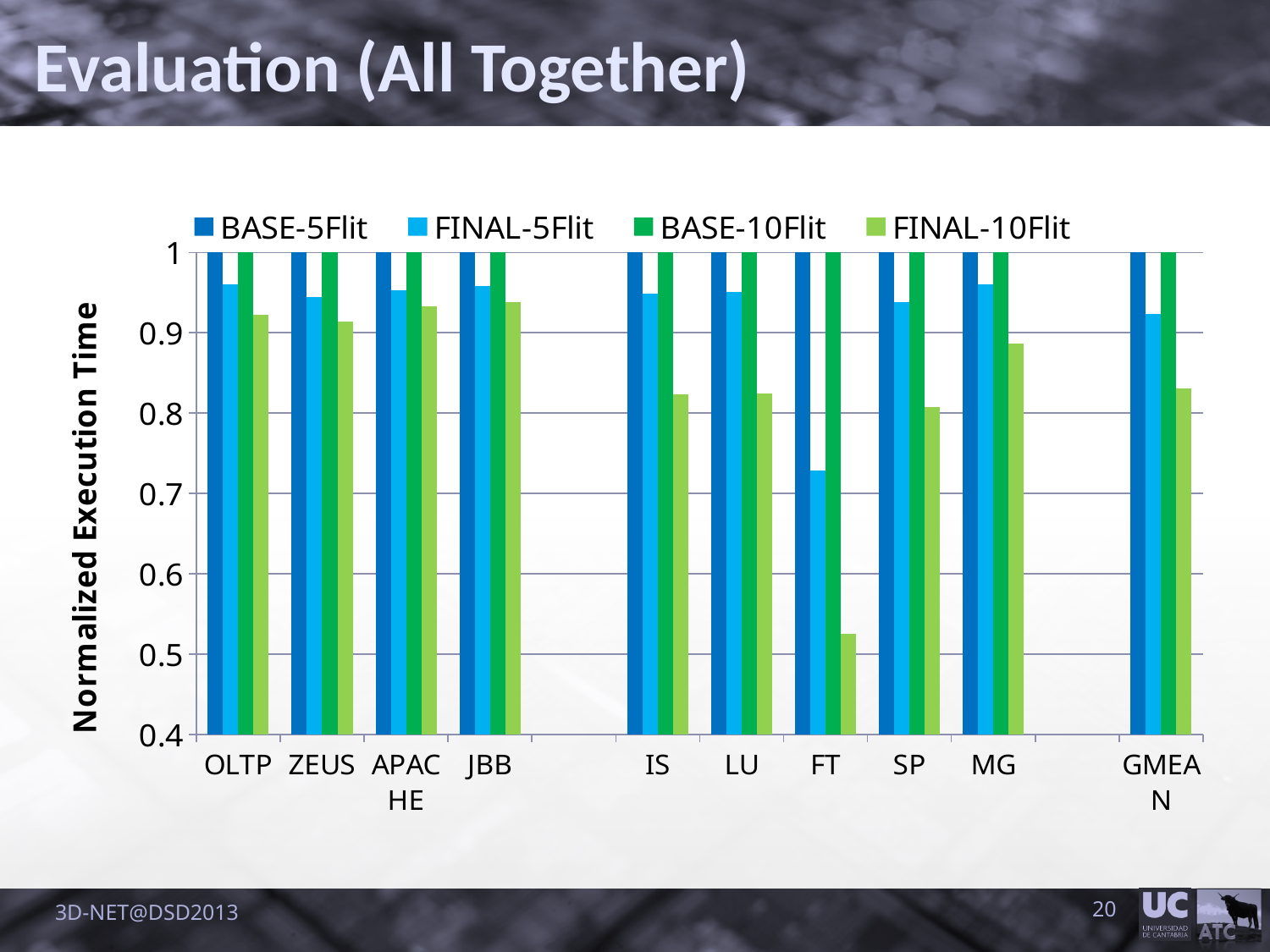
What is the label of the y axis? Normalized Execution Time How many categories are shown on the x axis? 10 Which category has the lowest FINAL-10Flit value? FT Which is larger, the FINAL-10Flit value for OLTP or for IS? OLTP What kind of chart is shown on the slide? bar chart Is the FINAL-10Flit value for GMEAN greater or less than 0.8? greater Which category has the lowest FINAL-5Flit value? FT What is the value of BASE-5Flit for OLTP? 1 Is the FINAL-10Flit value for IS greater or less than 0.9? less How many series does the legend list? 4 Is the FINAL-5Flit value for FT greater or less than 0.7? greater